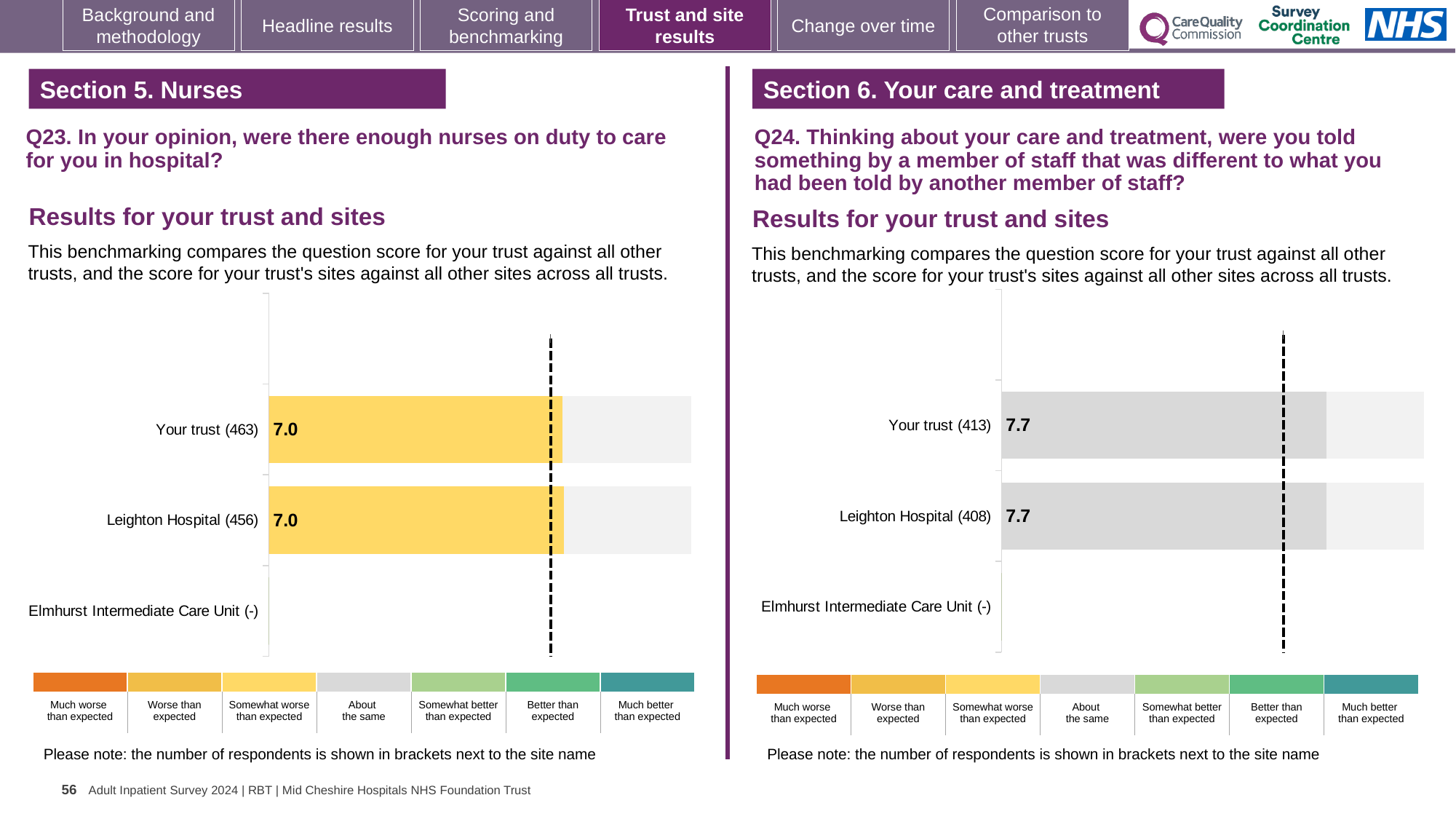
In the Q24 chart on the right, what is the score for Leighton Hospital? 7.7 In the Q23 chart on the left, what is the score for Leighton Hospital? 7.0 In the Q23 chart on the left, how many respondents are shown in brackets for Your trust? 463 In the Q24 chart on the right, which site has no score shown? Elmhurst Intermediate Care Unit In the Q24 chart on the right, how many respondents are shown in brackets for Leighton Hospital? 408 In the Q23 chart on the left, what is the score for Your trust? 7.0 In the Q23 chart on the left, what is the difference between the scores for Your trust and Leighton Hospital? 0.0 What kind of chart is used for the Q24 results on the right? Bar chart In the Q24 chart on the right, which benchmark category does the colour of the Your trust bar correspond to? About the same In the Q23 chart on the left, how many sites or categories are listed on the vertical axis? 3 In the Q24 chart on the right, what is the score for Your trust? 7.7 In the Q23 chart on the left, which benchmark category does the colour of the Your trust bar correspond to? Somewhat worse than expected